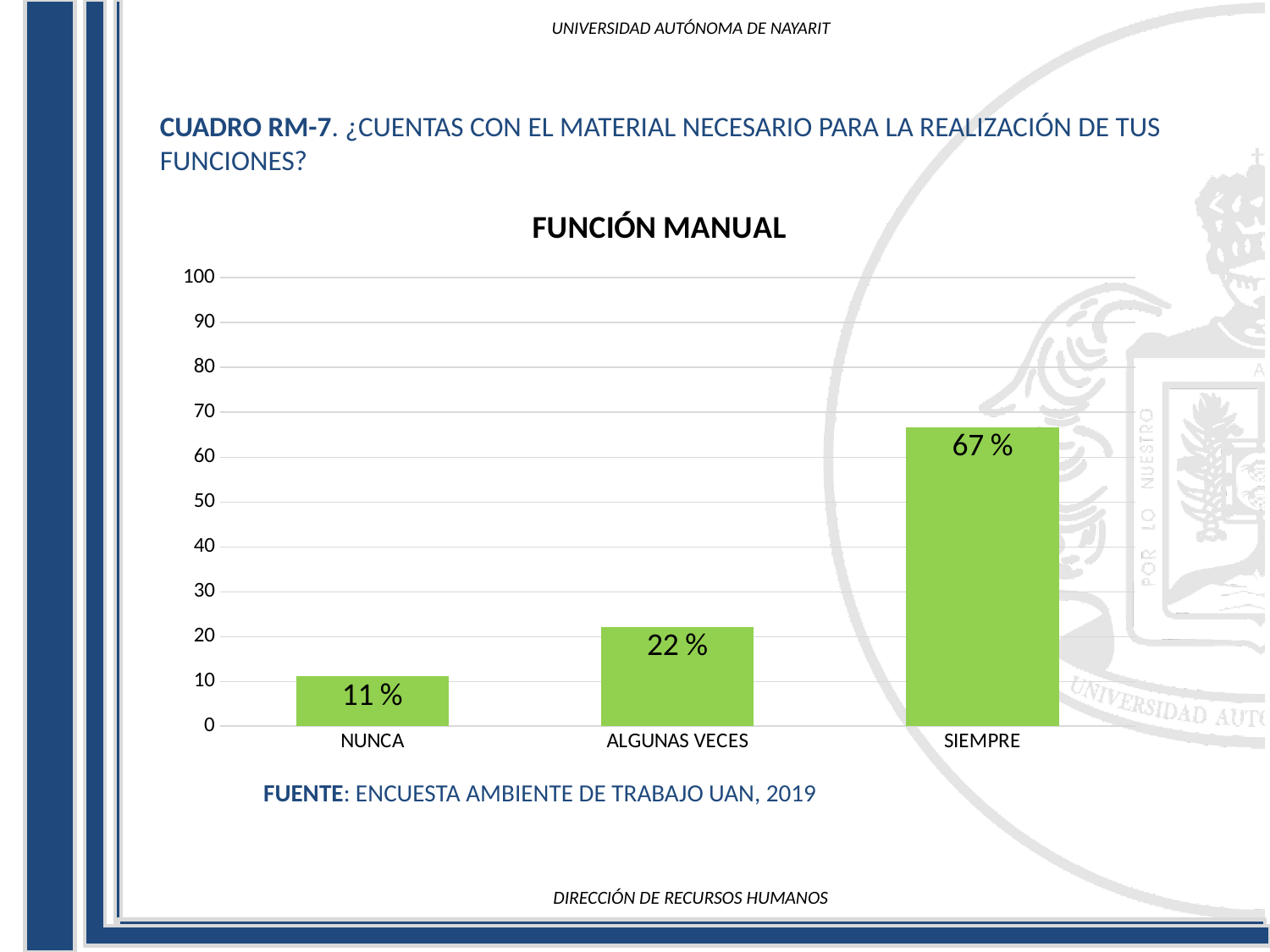
Is the value for SIEMPRE greater or less than 50? greater What is the difference between the values for SIEMPRE and ALGUNAS VECES? 45 % What kind of chart is shown on the slide? bar chart Which category has the lowest value? NUNCA What is the value for NUNCA? 11 % Which category has the highest value? SIEMPRE What is the difference between the values for ALGUNAS VECES and NUNCA? 11 % What is the value for SIEMPRE? 67 % What is the title of the chart? FUNCIÓN MANUAL How many categories are shown on the x axis? 3 What is the value for ALGUNAS VECES? 22 % Which is larger, the value for ALGUNAS VECES or the value for NUNCA? ALGUNAS VECES